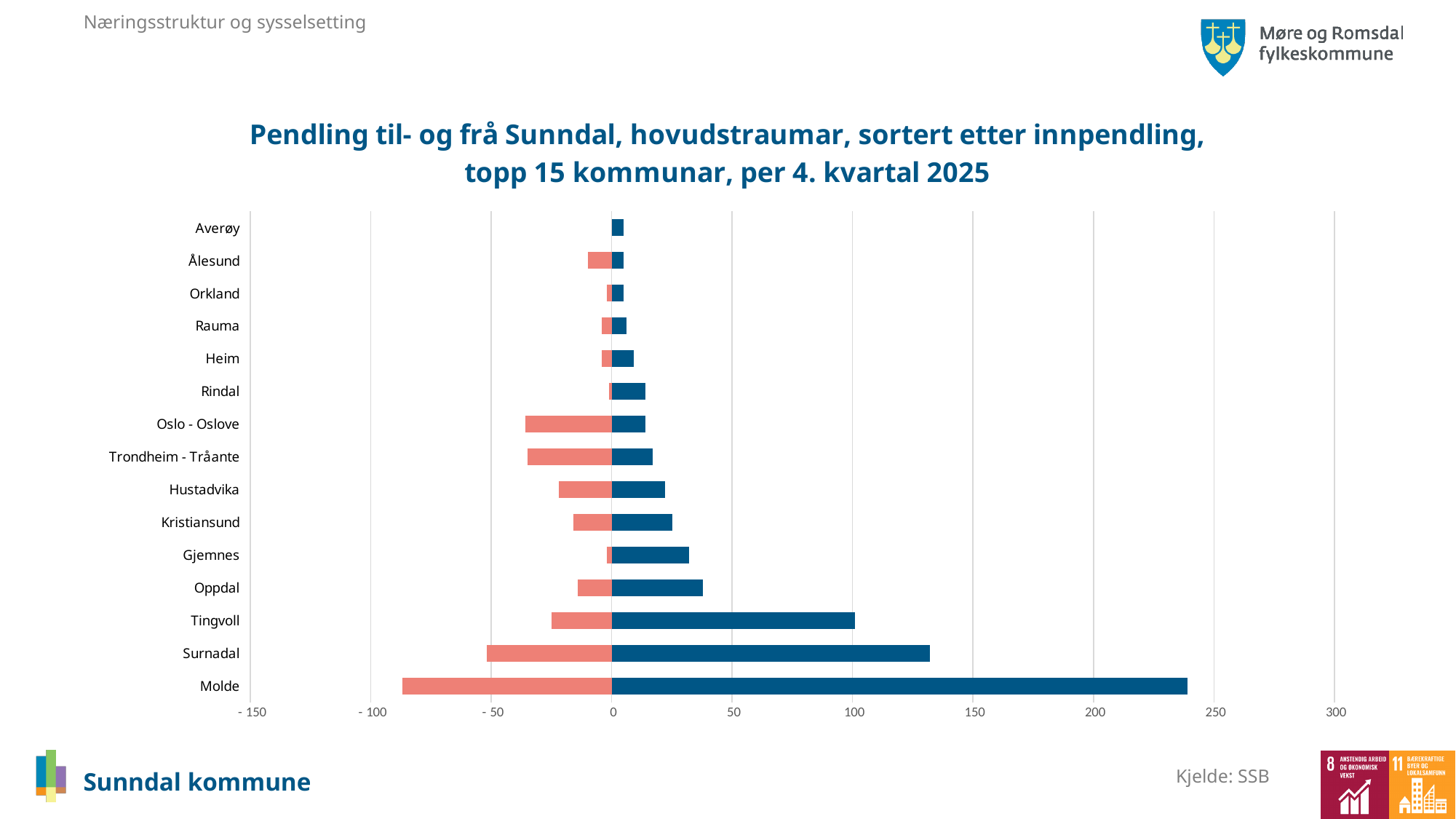
Is the blue bar value for Molde greater or less than 200? greater Is the blue bar value for Tingvoll greater or less than 50? greater What is the title of the chart? Pendling til- og frå Sunndal, hovudstraumar, sortert etter innpendling, topp 15 kommunar, per 4. kvartal 2025 Which municipality has the longest blue (positive) bar? Molde Is the red bar value for Molde greater or less than -50? less How many municipalities (categories) are listed on the chart? 15 Which municipality has the longest red (negative) bar? Molde Which has the longer blue bar, Gjemnes or Kristiansund? Gjemnes Which has the longer blue bar, Surnadal or Tingvoll? Surnadal What kind of chart is shown on the slide? bar chart